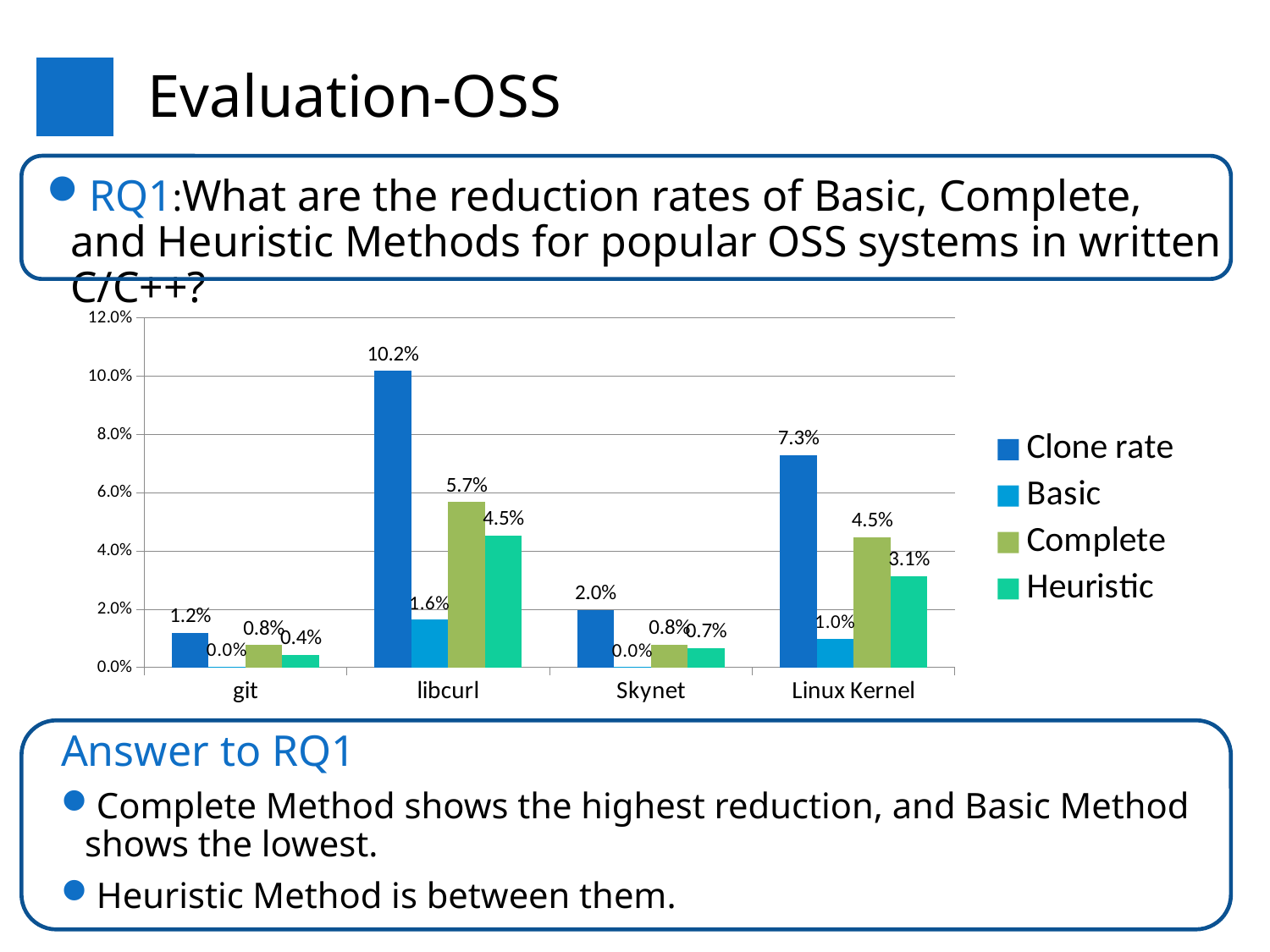
How many categories are shown on the x axis? 4 Which category has the lowest Heuristic value? git What is the Basic value for git? 0.0% How many series does the legend list? 4 What is the Complete value for Linux Kernel? 4.5% What is the Heuristic value for Skynet? 0.7% What kind of chart is shown on the slide? Bar chart Which series is shown in dark blue in the legend? Clone rate What is the difference between the Clone rate and the Complete value for libcurl? 4.5% Which category has the highest Clone rate? libcurl What is the Clone rate value for libcurl? 10.2% Which is larger for Linux Kernel, the Complete value or the Heuristic value? Complete